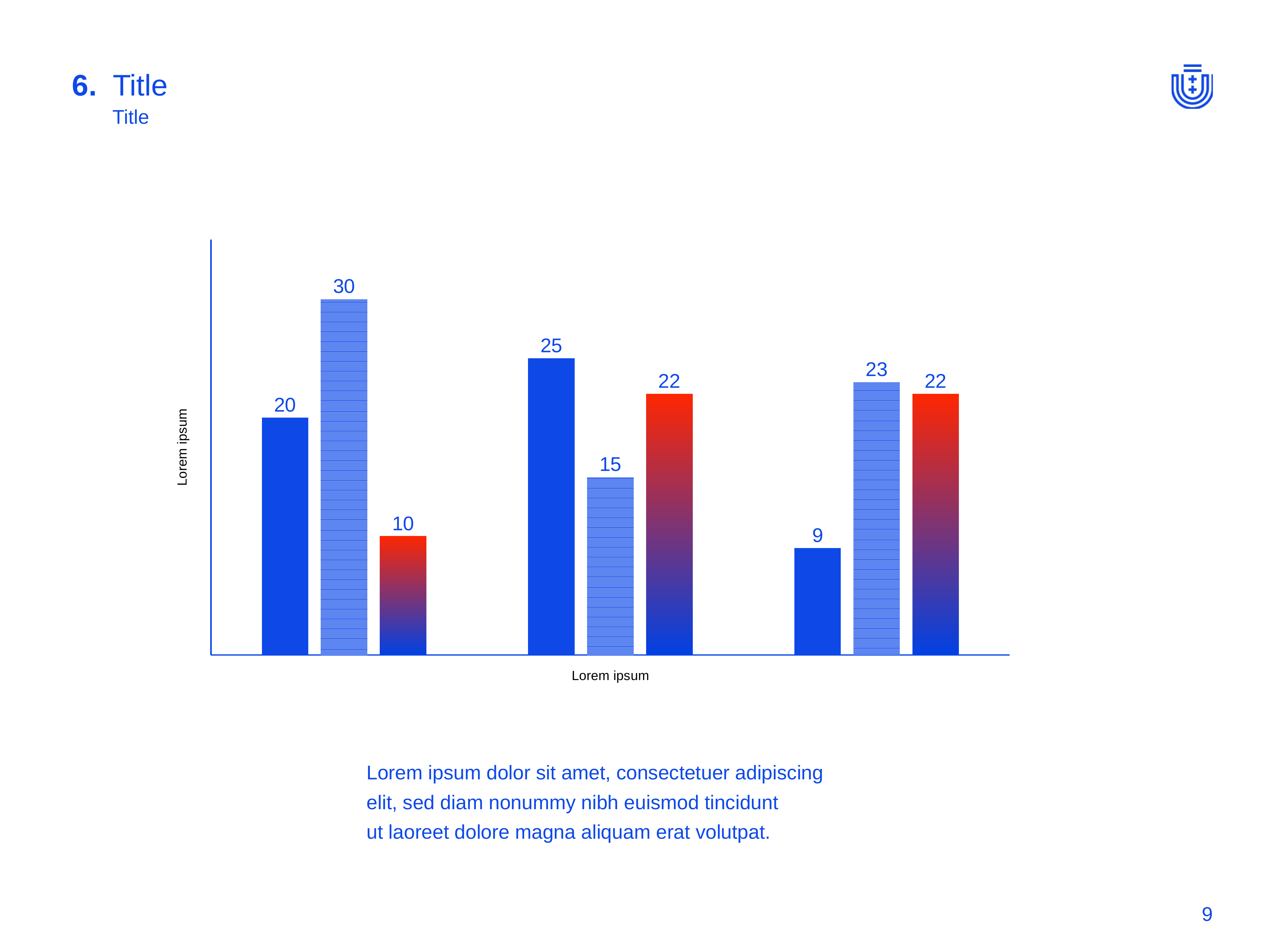
What is the value of the solid blue bar in the first (leftmost) group? 20 How many bars are plotted in the chart? 9 What is the value of the red bar in the second (middle) group? 22 In the first (leftmost) group, what is the difference between the striped bar and the red bar? 20 In the third (rightmost) group, what is the difference between the striped bar and the solid blue bar? 14 What kind of chart is shown on the slide? bar chart How many groups of bars does the chart contain? 3 What is the label on the vertical axis of the chart? Lorem ipsum What is the lowest value labelled on any bar in the chart? 9 Which is larger: the striped bar in the first group or the solid blue bar in the second group? the striped bar in the first group What is the highest value labelled on any bar in the chart? 30 What is the value of the striped bar in the third (rightmost) group? 23